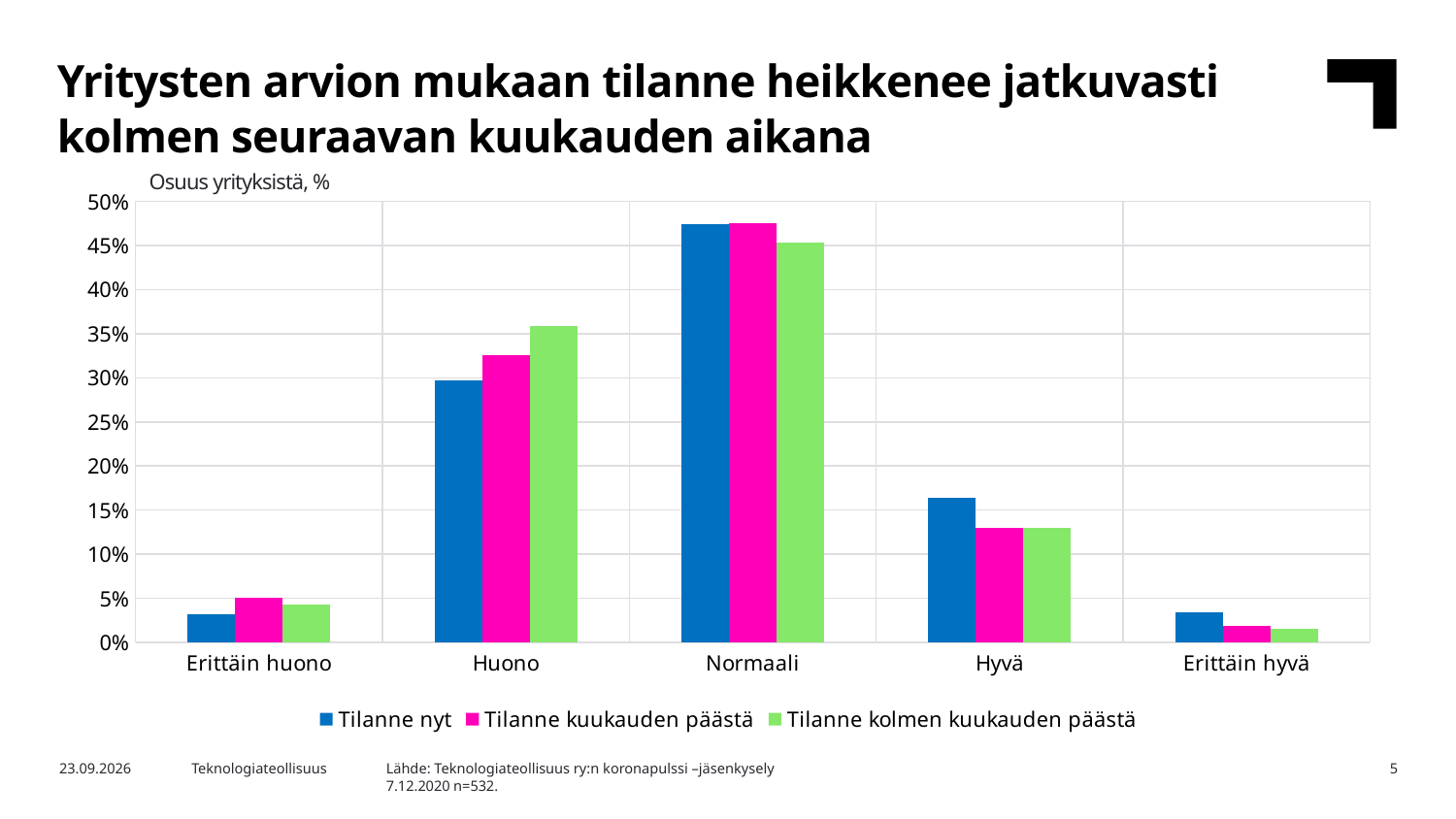
For the category Huono, which is larger: Tilanne nyt or Tilanne kolmen kuukauden päästä? Tilanne kolmen kuukauden päästä For the series Tilanne kolmen kuukauden päästä, which category has the lowest value? Erittäin hyvä Is the value for Normaali in the series Tilanne nyt greater or less than 45%? greater For the category Hyvä, which is larger: Tilanne nyt or Tilanne kuukauden päästä? Tilanne nyt Is the value for Huono in the series Tilanne nyt greater or less than 25%? greater What kind of chart is shown on the slide? bar chart How many categories are shown on the x axis of the chart? 5 What label is shown above the y axis of the chart? Osuus yrityksistä, % For the series Tilanne nyt, which category has the highest value? Normaali Is the value for Hyvä in the series Tilanne nyt greater or less than 15%? greater How many series does the chart's legend list? 3 For the category Huono, do the values rise or fall going from Tilanne nyt to Tilanne kolmen kuukauden päästä? rise